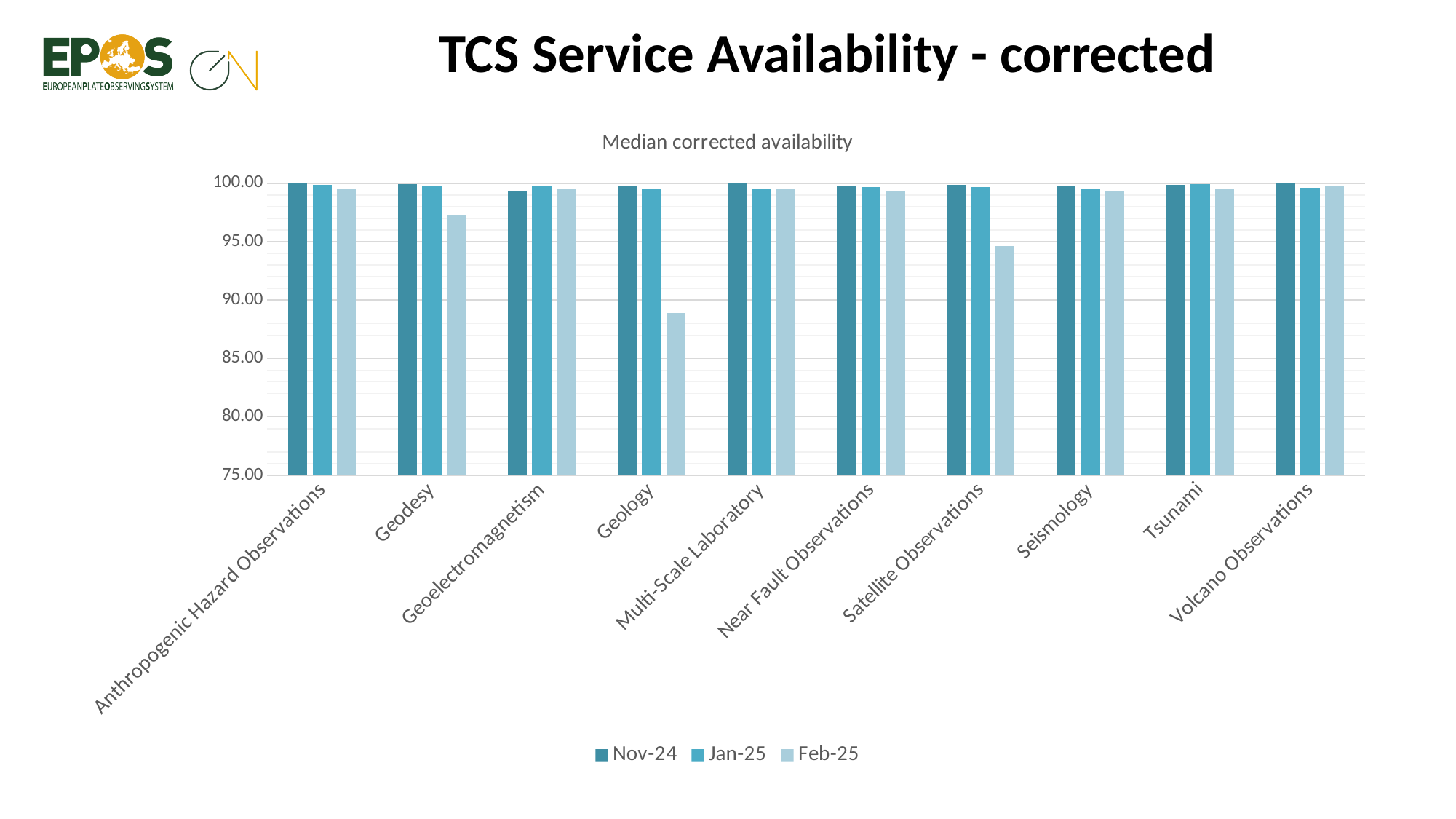
Is the Feb-25 value for Geology greater or less than 90.00? less Which series are listed in the legend? Nov-24, Jan-25, Feb-25 Is the Feb-25 value for Geodesy greater or less than 95.00? greater Is the Nov-24 value for Tsunami greater or less than 95.00? greater Which is larger, the Feb-25 value for Geology or the Feb-25 value for Satellite Observations? Satellite Observations What kind of chart is shown on the slide? bar chart Which is larger, the Feb-25 value for Geodesy or the Feb-25 value for Satellite Observations? Geodesy What is the title printed above the chart? Median corrected availability How many categories are shown on the x axis of the chart? 10 How many series does the legend list? 3 Which category has the lowest Feb-25 value? Geology